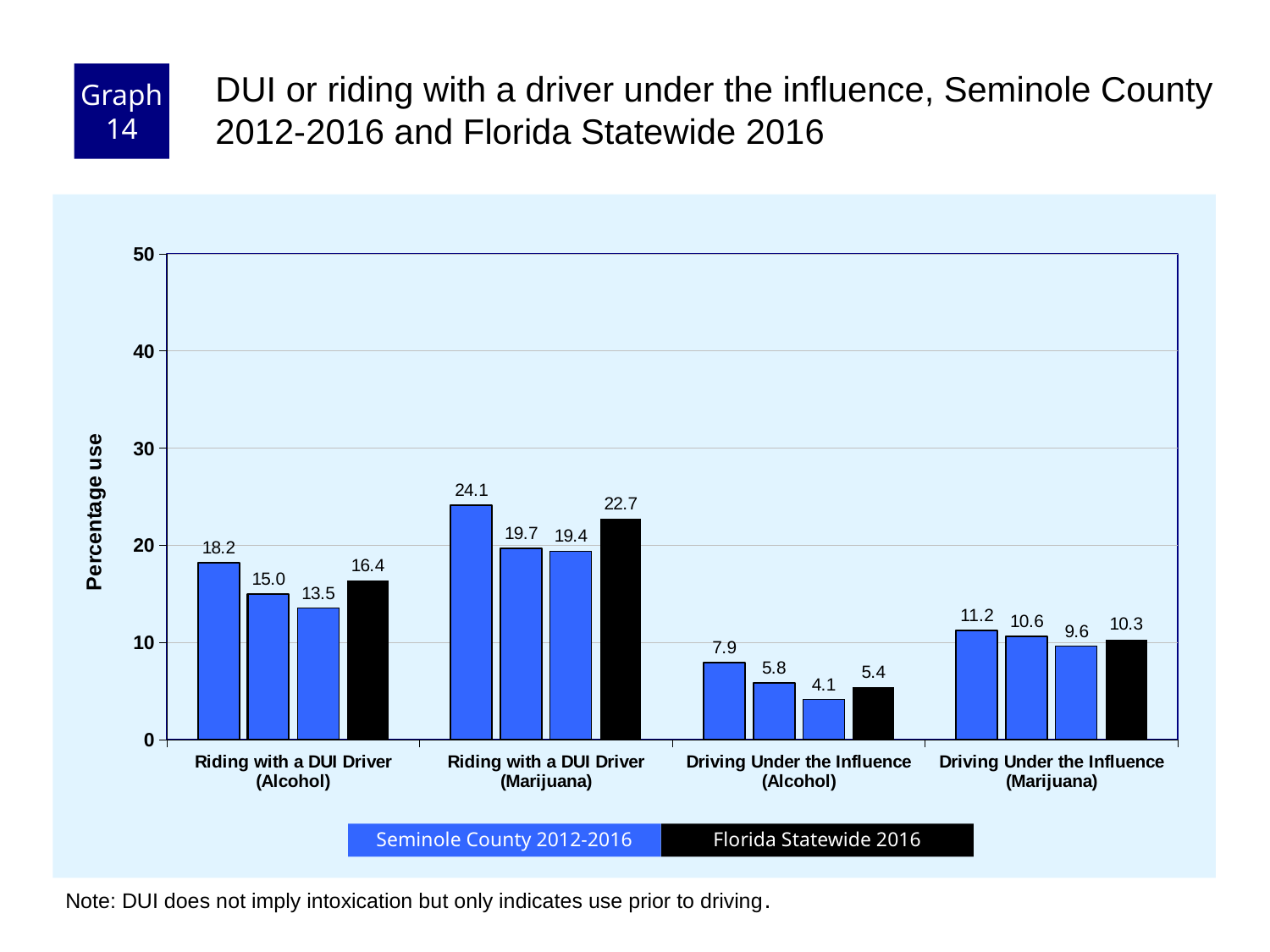
What is the Florida Statewide 2016 value for Driving Under the Influence (Alcohol)? 5.4 What is the lowest value labelled anywhere on the chart? 4.1 How many series does the legend list? 2 Which category has the lowest Florida Statewide 2016 value? Driving Under the Influence (Alcohol) Which is larger: the Florida Statewide 2016 value for Riding with a DUI Driver (Alcohol) or for Driving Under the Influence (Marijuana)? Riding with a DUI Driver (Alcohol) What is the Florida Statewide 2016 value for Riding with a DUI Driver (Marijuana)? 22.7 Which category has the highest Florida Statewide 2016 value? Riding with a DUI Driver (Marijuana) What is the highest value labelled anywhere on the chart? 24.1 What is the Florida Statewide 2016 value for Driving Under the Influence (Marijuana)? 10.3 What is the difference between the Florida Statewide 2016 values for Riding with a DUI Driver (Marijuana) and Riding with a DUI Driver (Alcohol)? 6.3 What kind of chart is shown on the slide? Bar chart How many categories are shown on the x axis? 4